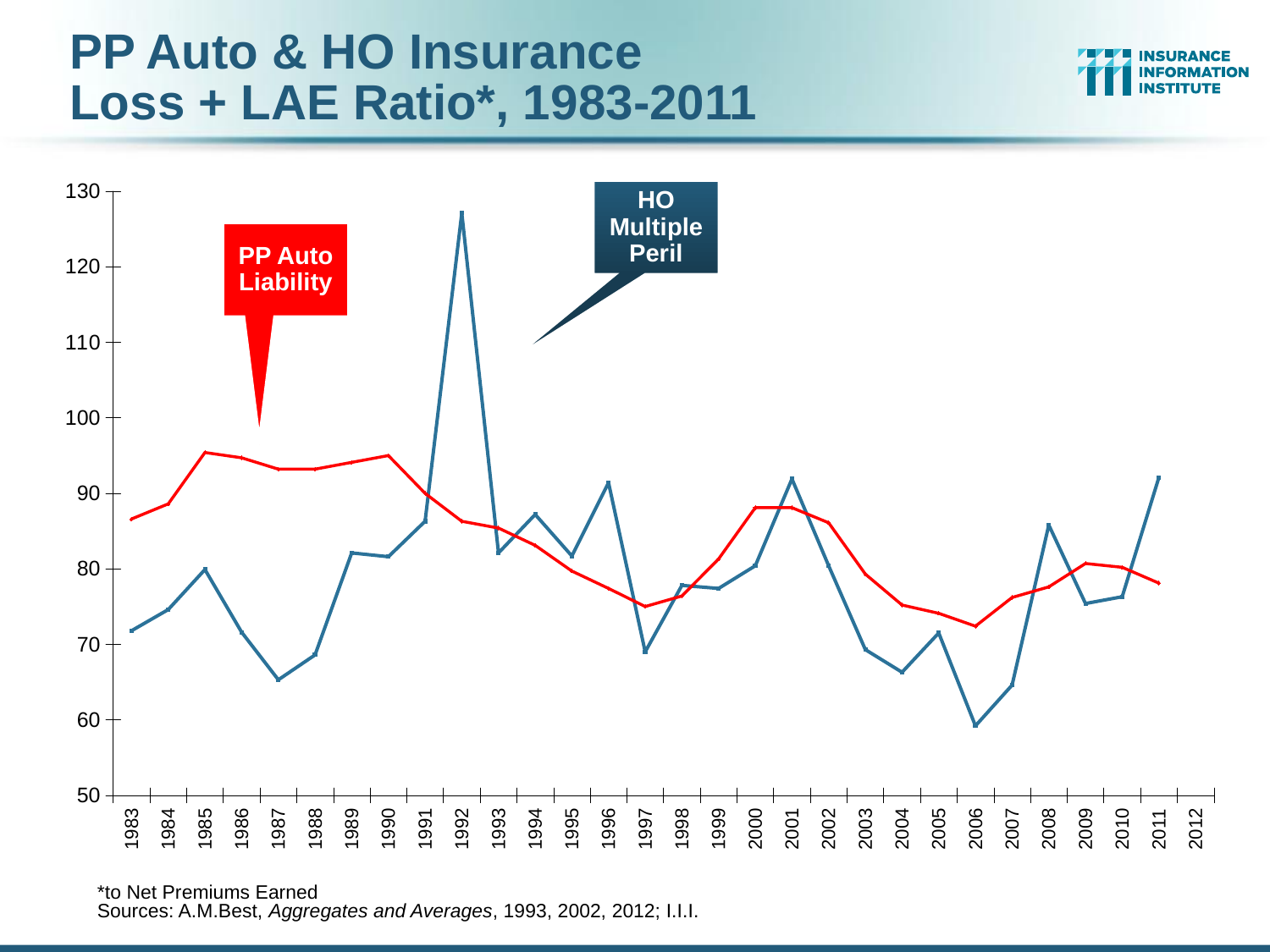
How many series are plotted on the chart? 2 Is the PP Auto Liability value for 1985 greater or less than 90? greater Is the PP Auto Liability value for 1997 greater or less than 80? less What kind of chart is shown on the slide? line chart In 1987, which series has the higher value, PP Auto Liability or HO Multiple Peril? PP Auto Liability What are the names of the two series plotted on the chart? PP Auto Liability and HO Multiple Peril Does the PP Auto Liability line rise or fall from 1990 to 1997? fall Is the HO Multiple Peril value for 2006 greater or less than 60? less In which year does the HO Multiple Peril line reach its highest value? 1992 What colour is the PP Auto Liability line? red In which year does the HO Multiple Peril line reach its lowest value? 2006